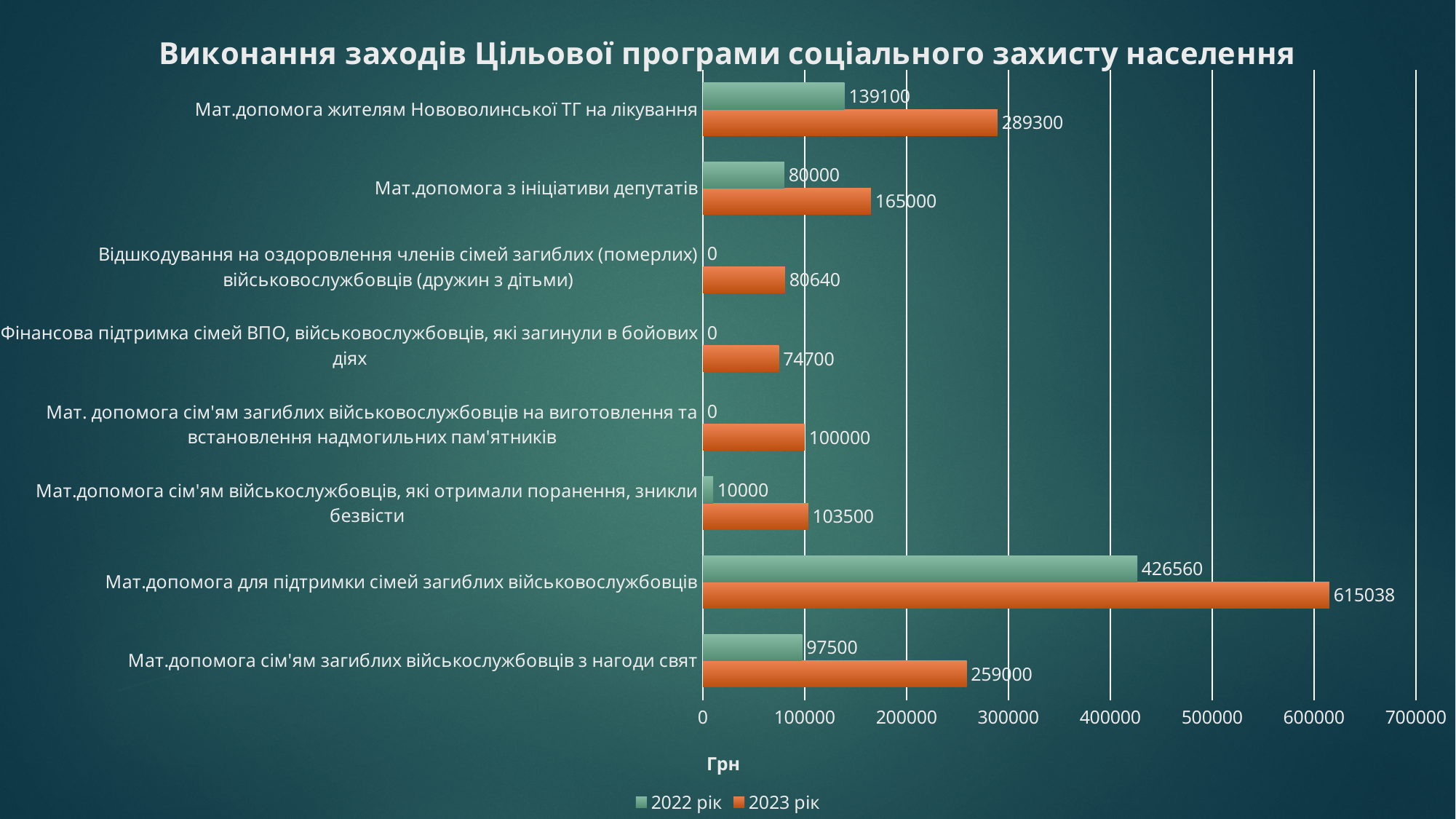
Which is larger for "Мат.допомога з ініціативи депутатів": the 2022 рік value or the 2023 рік value? 2023 рік How many categories are shown on the chart? 8 What is the difference between the 2023 рік and 2022 рік values for "Мат.допомога сім'ям загиблих військослужбовців з нагоди свят"? 161500 What is the 2022 рік value for "Мат.допомога сім'ям військослужбовців, які отримали поранення, зникли безвісти"? 10000 What is the 2023 рік value for "Мат.допомога для підтримки сімей загиблих військовослужбовців"? 615038 What is the 2022 рік value for "Мат.допомога жителям Нововолинської ТГ на лікування"? 139100 How many series does the legend list? 2 What type of chart is shown on the slide? Bar chart Which category has the lowest 2023 рік value? Фінансова підтримка сімей ВПО, військовослужбовців, які загинули в бойових діях What is the 2023 рік value for "Фінансова підтримка сімей ВПО, військовослужбовців, які загинули в бойових діях"? 74700 What is the label of the horizontal axis? Грн Which category has the highest 2023 рік value? Мат.допомога для підтримки сімей загиблих військовослужбовців